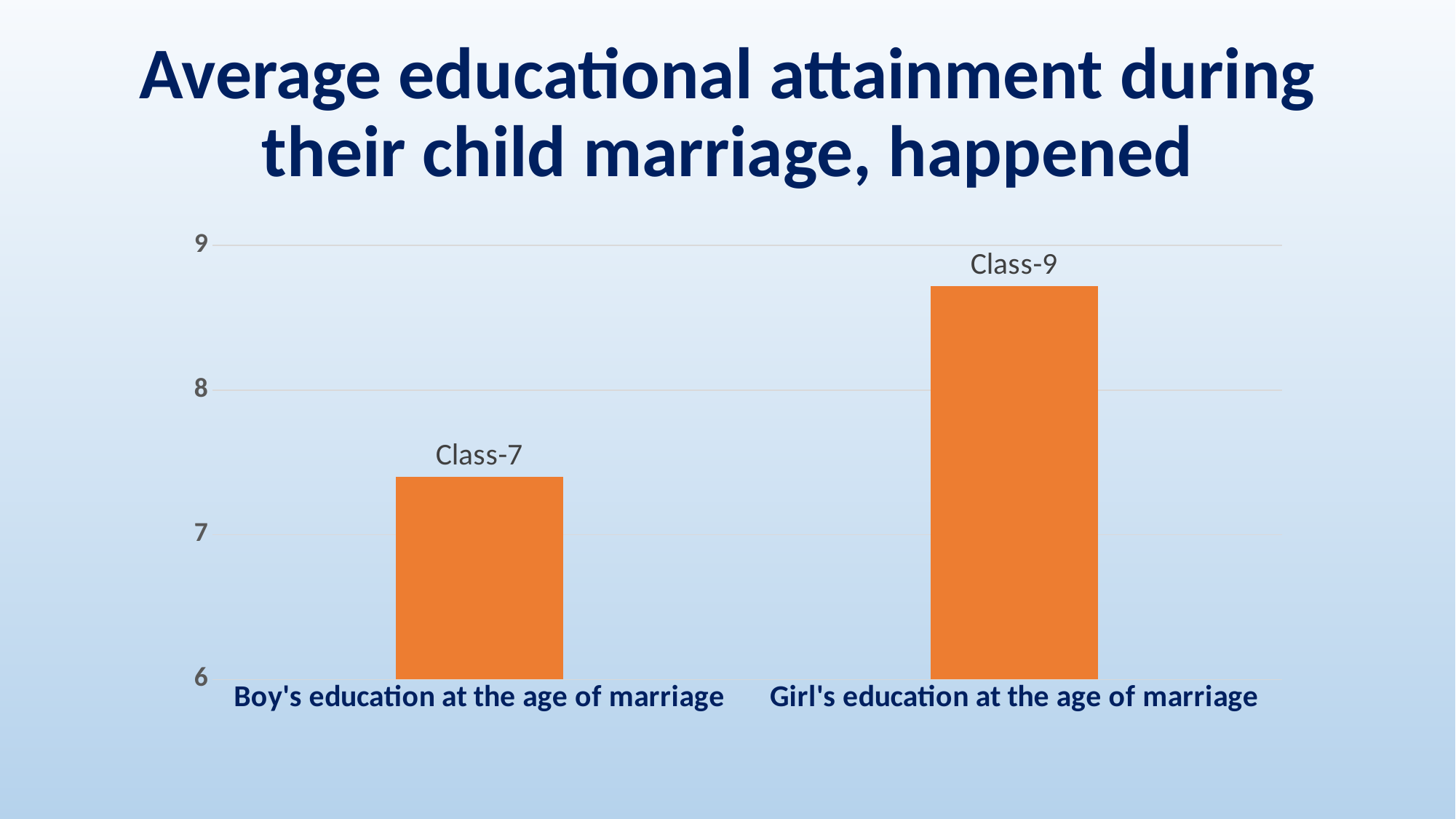
Is the value for Boy's education at the age of marriage greater or less than 8? less What is the title of the slide? Average educational attainment during their child marriage, happened Is the value for Girl's education at the age of marriage greater or less than 9? less What is the data label shown on the bar for Boy's education at the age of marriage? Class-7 Which category has the lowest bar? Boy's education at the age of marriage How many categories are shown on the chart? 2 Is the value for Boy's education at the age of marriage greater or less than 7? greater Which category has the highest bar? Girl's education at the age of marriage What kind of chart is shown on the slide? Bar chart Which bar is taller: Boy's education at the age of marriage or Girl's education at the age of marriage? Girl's education at the age of marriage What is the data label shown on the bar for Girl's education at the age of marriage? Class-9